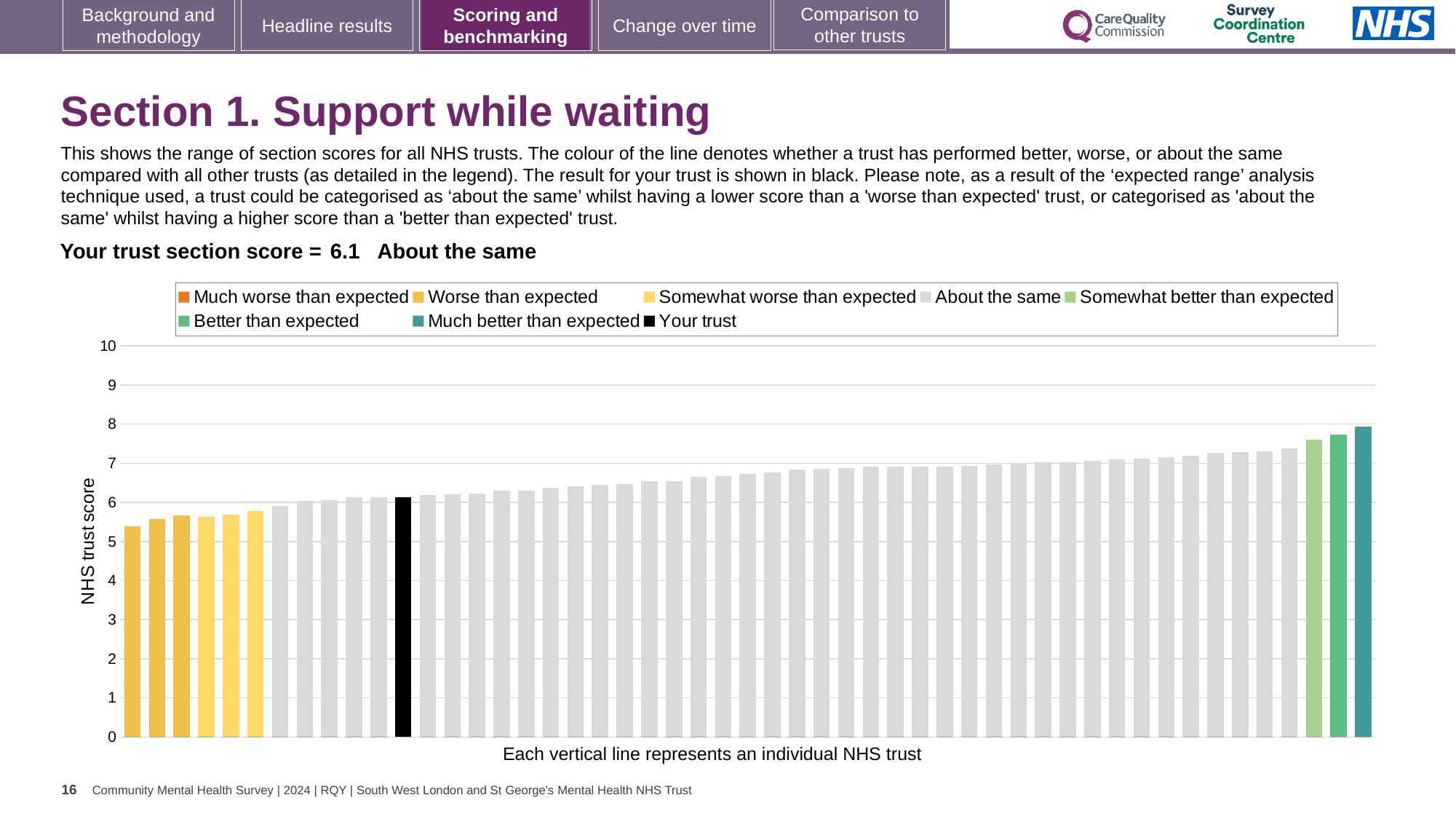
Is the lowest trust score on the chart greater or less than 6? less What kind of chart is used to show the NHS trust section scores? Bar chart How many bars on the chart are coloured teal for 'Much better than expected'? 1 Which legend category does the tallest bar on the chart belong to? Much better than expected Is the highest trust score on the chart greater or less than 7? greater What is the highest value shown on the vertical axis of the chart? 10 Which performance category is your trust placed in for Section 1? About the same What is the section score for your trust shown on the slide? 6.1 How many entries does the chart legend list? 8 Is the score for your trust (the black bar) greater or less than 5? greater Do the trust scores rise or fall from left to right along the x axis? Rise What is the label on the vertical axis of the chart? NHS trust score